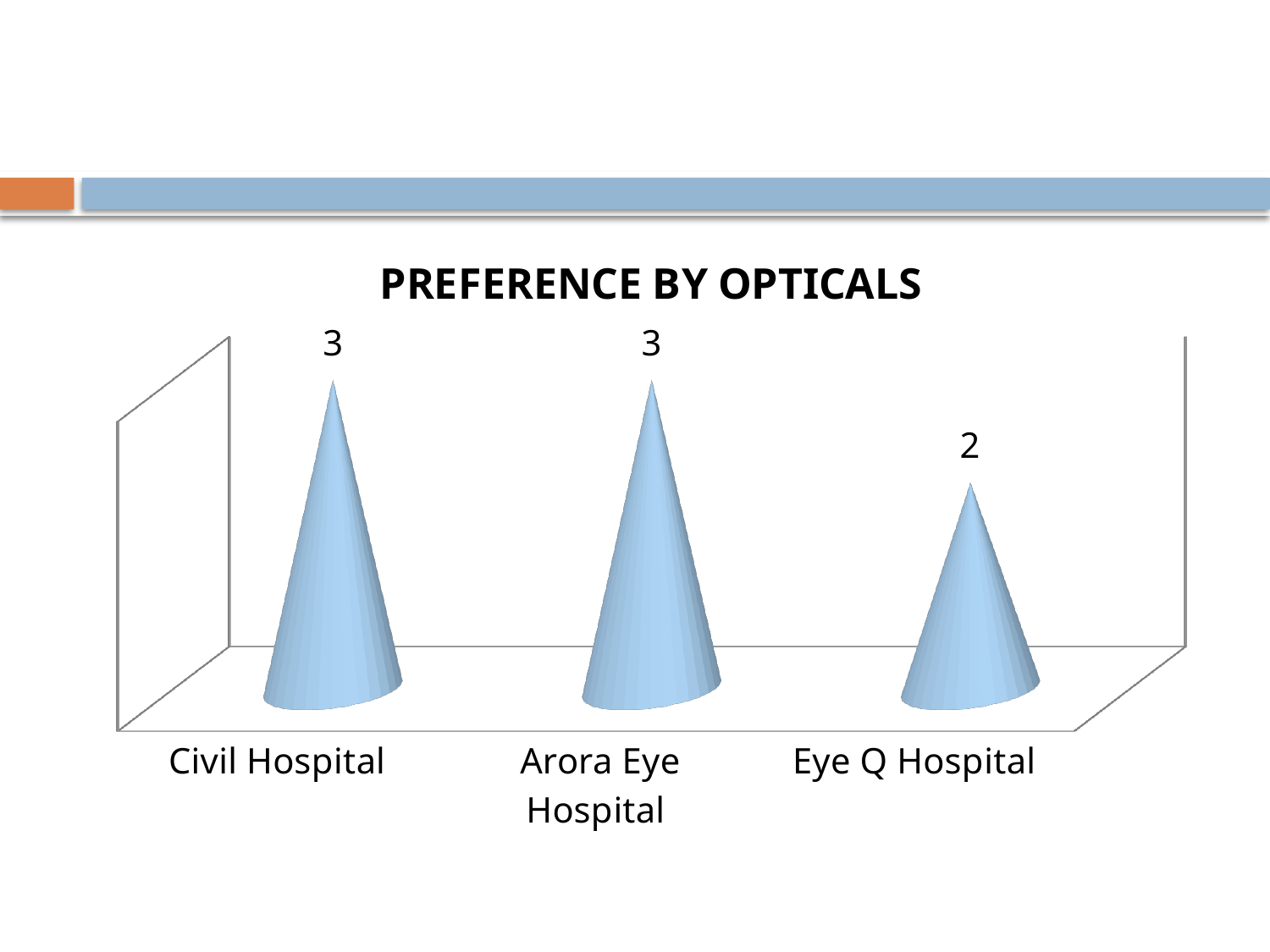
What is the title of the chart? PREFERENCE BY OPTICALS Which is larger, the value for Arora Eye Hospital or the value for Eye Q Hospital? Arora Eye Hospital How many categories are shown in the chart? 3 What kind of chart is shown on the slide? bar chart What is the difference between the values for Arora Eye Hospital and Eye Q Hospital? 1 What is the difference between the values for Civil Hospital and Eye Q Hospital? 1 What is the value for Civil Hospital? 3 What is the value for Eye Q Hospital? 2 What is the total of the values for all three hospitals? 8 Which category has the lowest value? Eye Q Hospital What is the value for Arora Eye Hospital? 3 Which is larger, the value for Civil Hospital or the value for Eye Q Hospital? Civil Hospital